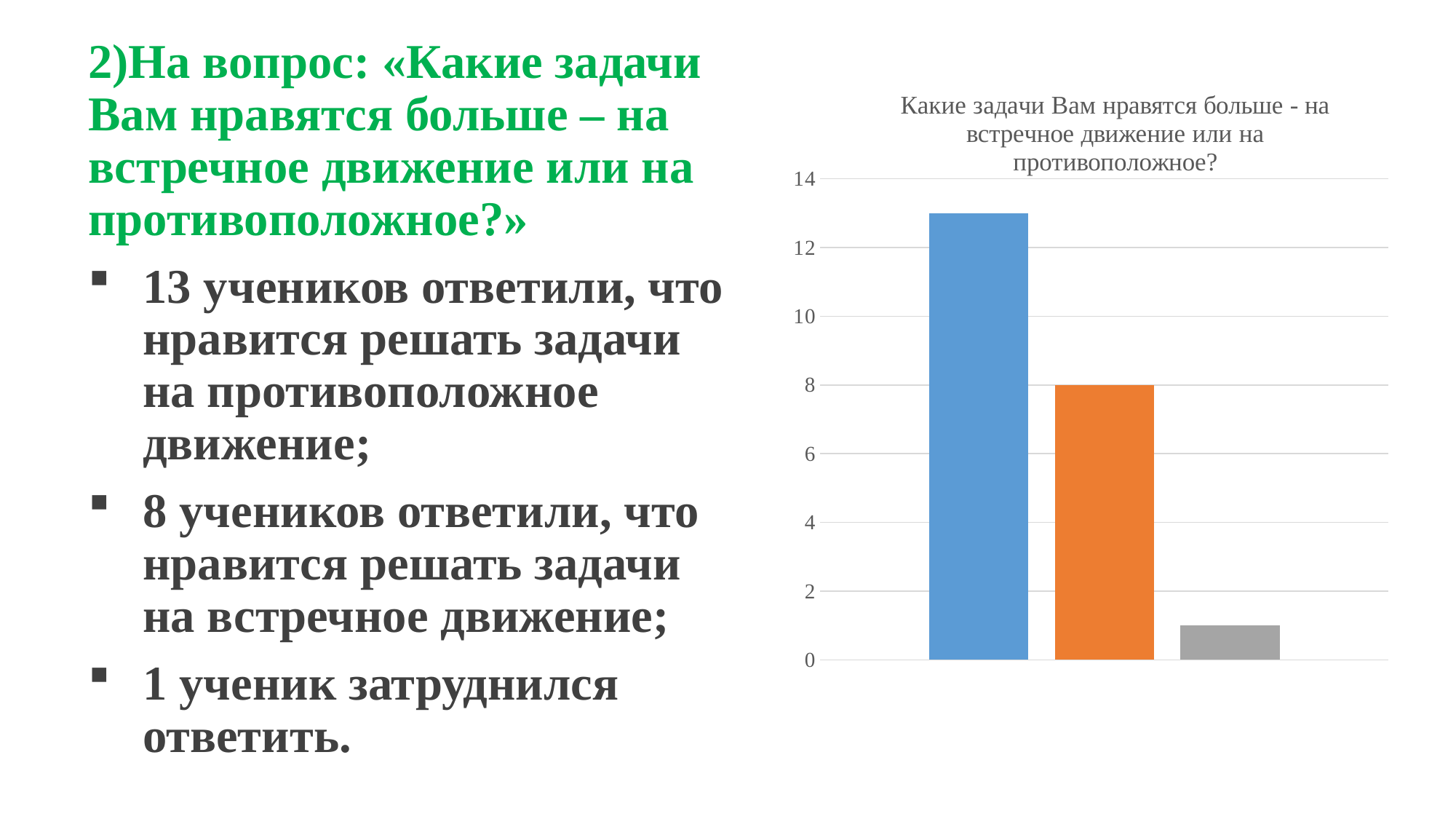
Which bar is the tallest in the chart: the blue, the orange or the grey one? the blue bar Is the value of the orange (middle) bar greater or less than 10? less Do the bar values rise or fall from left to right across the chart? fall Is the value of the grey (third) bar greater or less than 2? less What is the highest tick value shown on the vertical axis of the chart? 14 What is the title of the chart? Какие задачи Вам нравятся больше - на встречное движение или на противоположное? Is the value of the blue (first) bar greater or less than 12? greater What value does the orange (middle) bar reach on the vertical axis? 8 Which is larger, the blue bar or the orange bar? the blue bar What kind of chart is shown on the slide? bar chart How many bars does the chart show? 3 Which bar is the shortest in the chart: the blue, the orange or the grey one? the grey bar